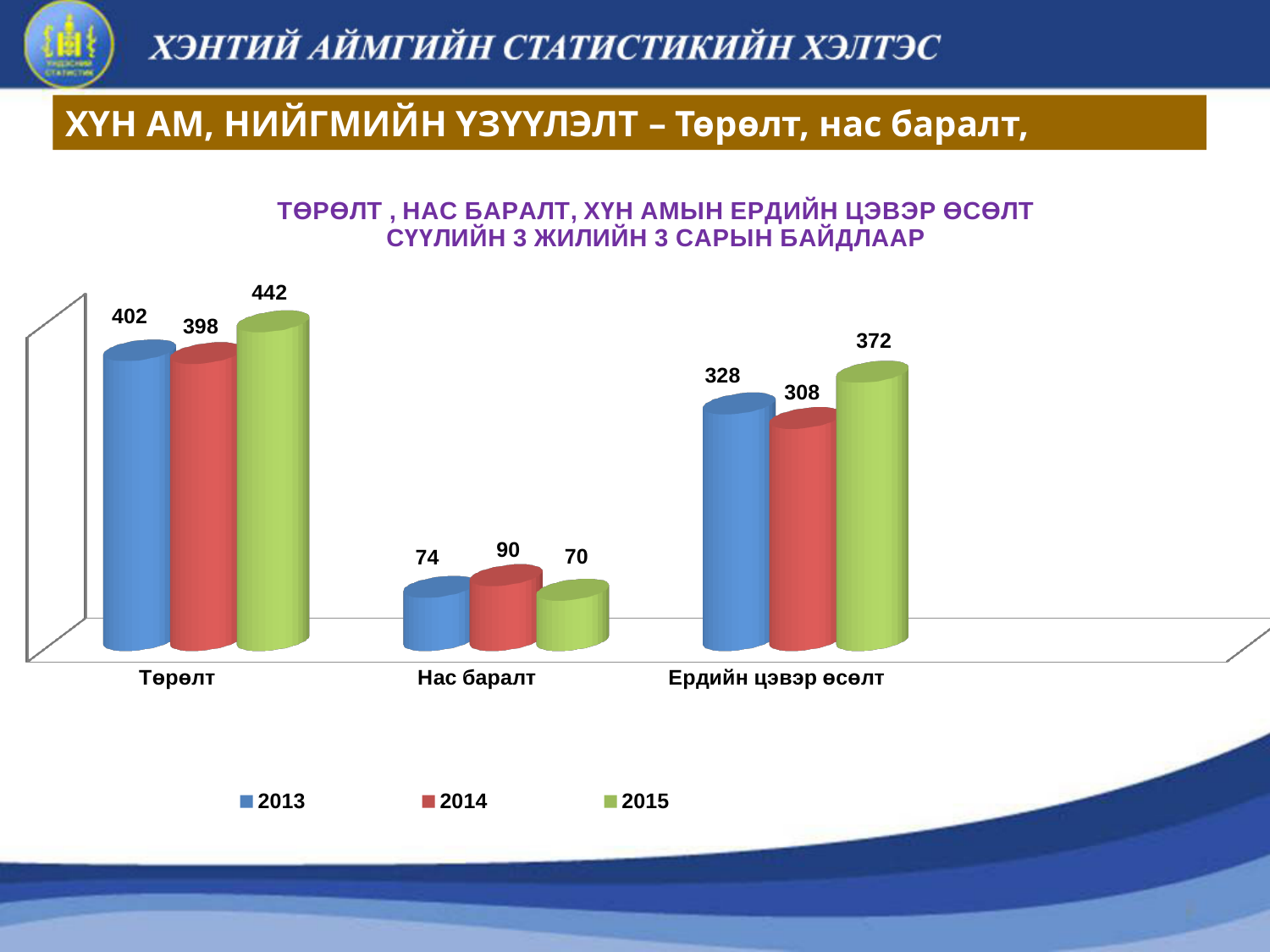
What is the value for Нас баралт in 2014? 90 Which year has the highest value for Төрөлт? 2015 What is the value for Ердийн цэвэр өсөлт in 2013? 328 What is the difference between the 2014 and 2015 values for Нас баралт? 20 Which year has the lowest value for Нас баралт? 2015 What is the difference between the 2015 and 2013 values for Ердийн цэвэр өсөлт? 44 How many categories are shown on the x axis? 3 Which is larger, the 2013 value for Төрөлт or the 2014 value for Төрөлт? 2013 Which series is shown in green in the legend? 2015 What is the value for Төрөлт in 2015? 442 What kind of chart is shown on the slide? bar chart How many series does the legend list? 3